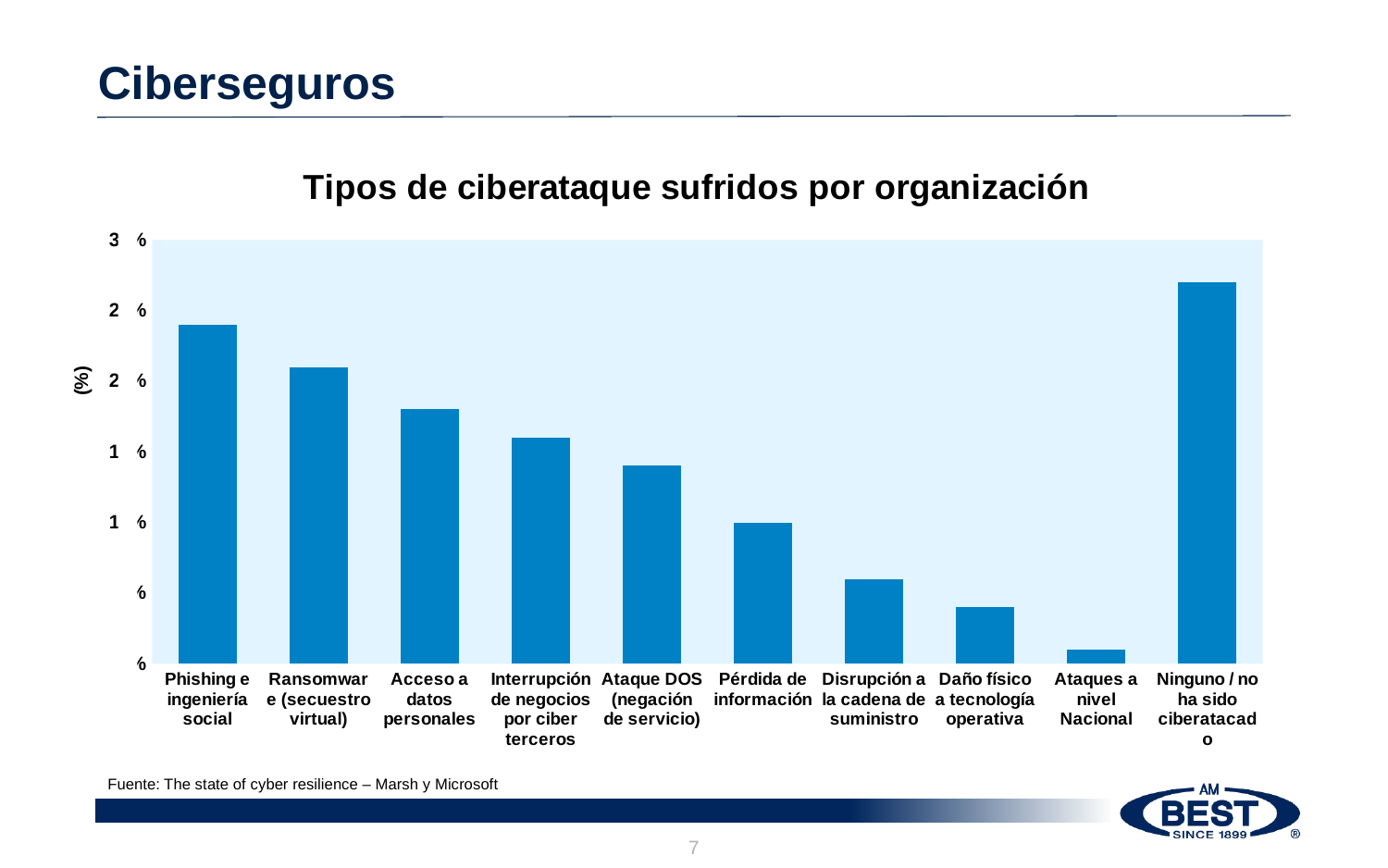
Which is larger: the bar for 'Interrupción de negocios por ciber terceros' or the bar for 'Ataque DOS (negación de servicio)'? Interrupción de negocios por ciber terceros What type of chart is shown on the slide? Bar chart Which is larger: the bar for 'Acceso a datos personales' or the bar for 'Pérdida de información'? Acceso a datos personales Which type of cyberattack has the highest bar among the attack categories (excluding 'Ninguno / no ha sido ciberatacado')? Phishing e ingeniería social Which category has the lowest bar in the chart? Ataques a nivel Nacional What is the title of the chart? Tipos de ciberataque sufridos por organización How many categories are shown on the x axis of the chart? 10 Which is larger: the bar for 'Phishing e ingeniería social' or the bar for 'Ransomware (secuestro virtual)'? Phishing e ingeniería social From 'Phishing e ingeniería social' through 'Ataques a nivel Nacional', do the bar values rise or fall from left to right? Fall What is the label on the vertical axis of the chart? (%) Which category has the highest bar in the chart? Ninguno / no ha sido ciberatacado